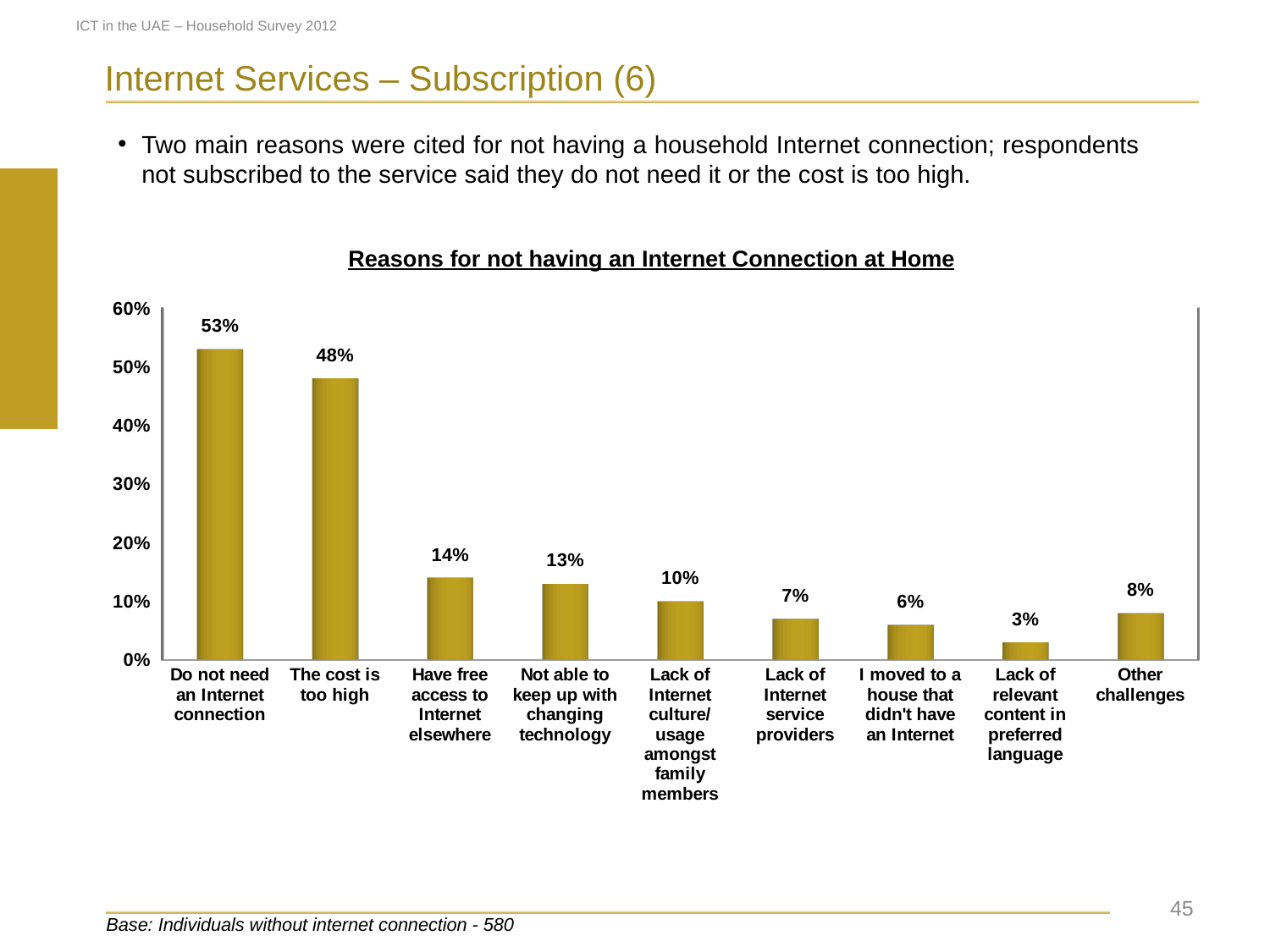
What is the difference between "Do not need an Internet connection" and "The cost is too high"? 5% How many reasons are shown in the chart? 9 What percentage of respondents cited "Do not need an Internet connection" as a reason for not having an Internet connection at home? 53% Is the value for "Not able to keep up with changing technology" greater or less than 10%? greater What kind of chart is shown on the slide? Bar chart Which is larger: "Have free access to Internet elsewhere" or "Other challenges"? Have free access to Internet elsewhere What is the value for "The cost is too high"? 48% What percentage cited "Lack of Internet service providers"? 7% What is the title of the chart? Reasons for not having an Internet Connection at Home Which reason has the highest percentage? Do not need an Internet connection Which reason has the lowest percentage? Lack of relevant content in preferred language What is the difference between "Lack of Internet culture/usage amongst family members" and "I moved to a house that didn't have an Internet"? 4%